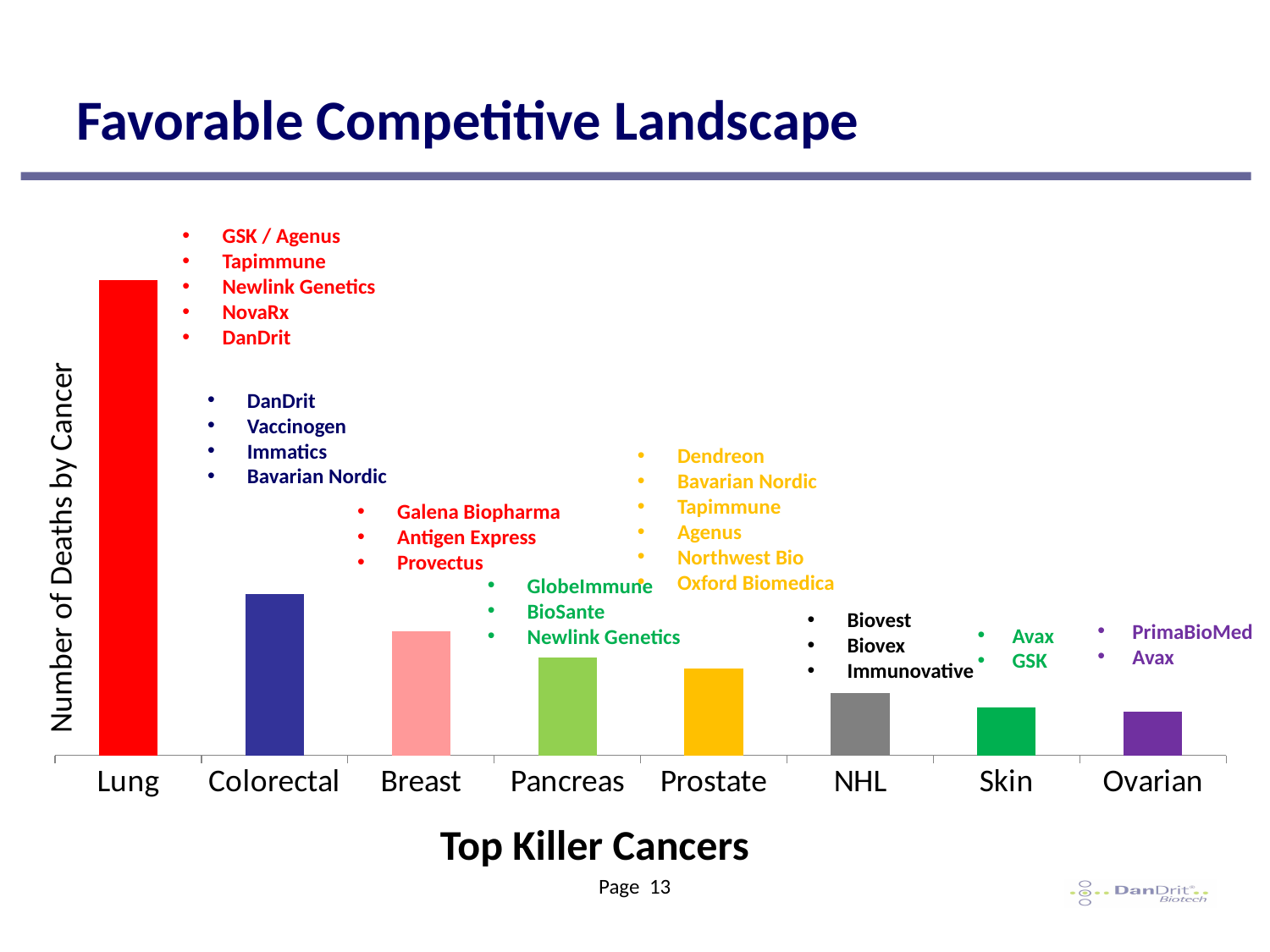
Do the bar heights rise or fall moving from left to right along the x axis? fall Which bar is taller, Colorectal or Prostate? Colorectal Which cancer has the lowest bar in the chart? Ovarian How many cancer categories are plotted on the chart? 8 What is the label on the y axis of the chart? Number of Deaths by Cancer Which bar is taller, Breast or NHL? Breast Which bar is taller, Breast or Pancreas? Breast What is the label on the x axis of the chart? Top Killer Cancers Which cancer has the second-tallest bar in the chart? Colorectal Which cancer has the highest number of deaths in the chart? Lung What kind of chart is shown on the slide? bar chart